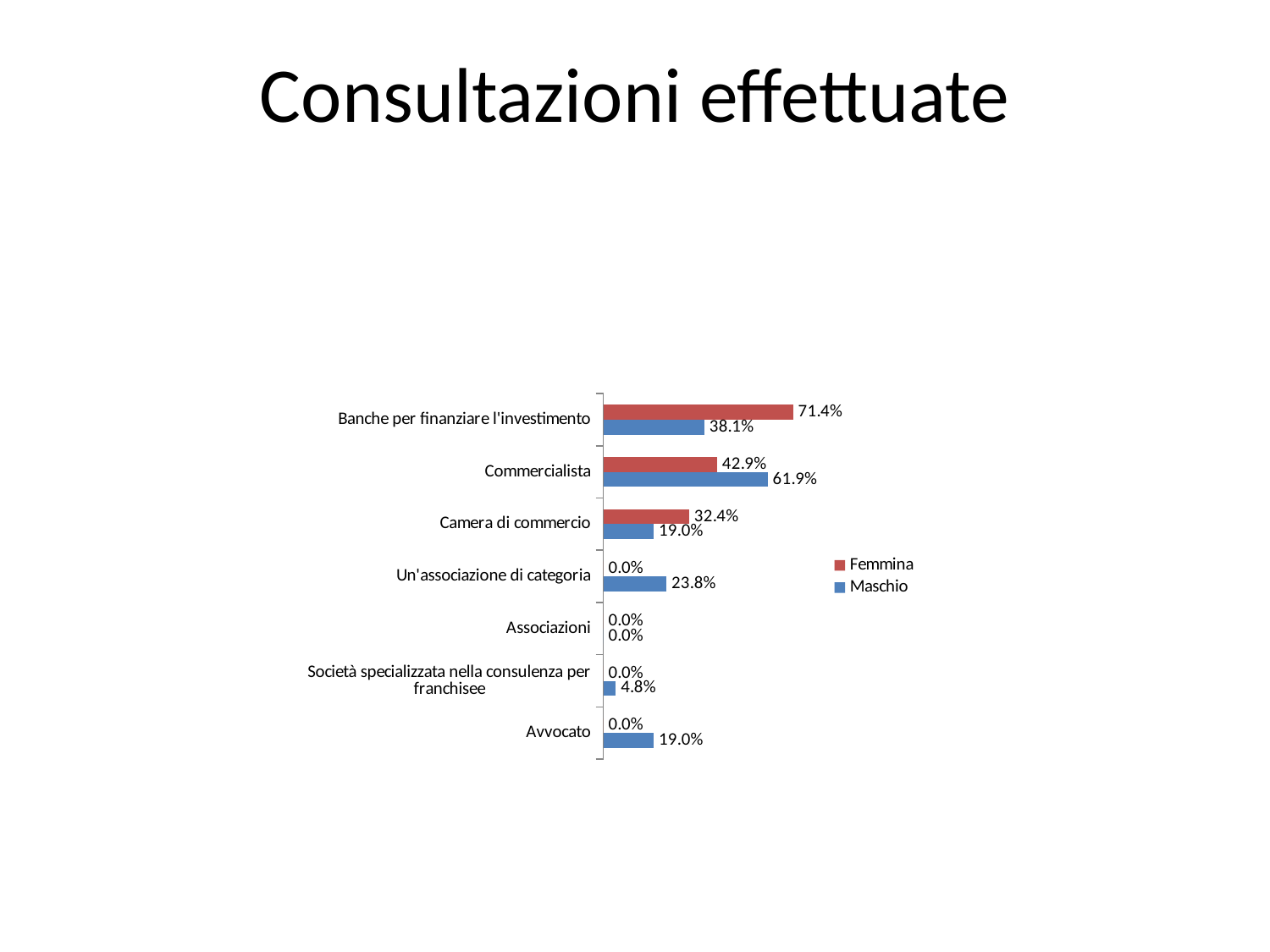
Which category has the highest Maschio value? Commercialista What is the difference between the Maschio and Femmina values for Commercialista? 19.0% What kind of chart is shown on the slide? Bar chart How many series does the legend list? 2 For Camera di commercio, which is larger, the Femmina or the Maschio value? Femmina What is the Maschio value for Società specializzata nella consulenza per franchisee? 4.8% What is the Femmina value for Banche per finanziare l'investimento? 71.4% Which category has the highest Femmina value? Banche per finanziare l'investimento What is the difference between the Femmina and Maschio values for Banche per finanziare l'investimento? 33.3% How many categories are shown on the chart? 7 What is the Maschio value for Commercialista? 61.9% What is the Maschio value for Un'associazione di categoria? 23.8%